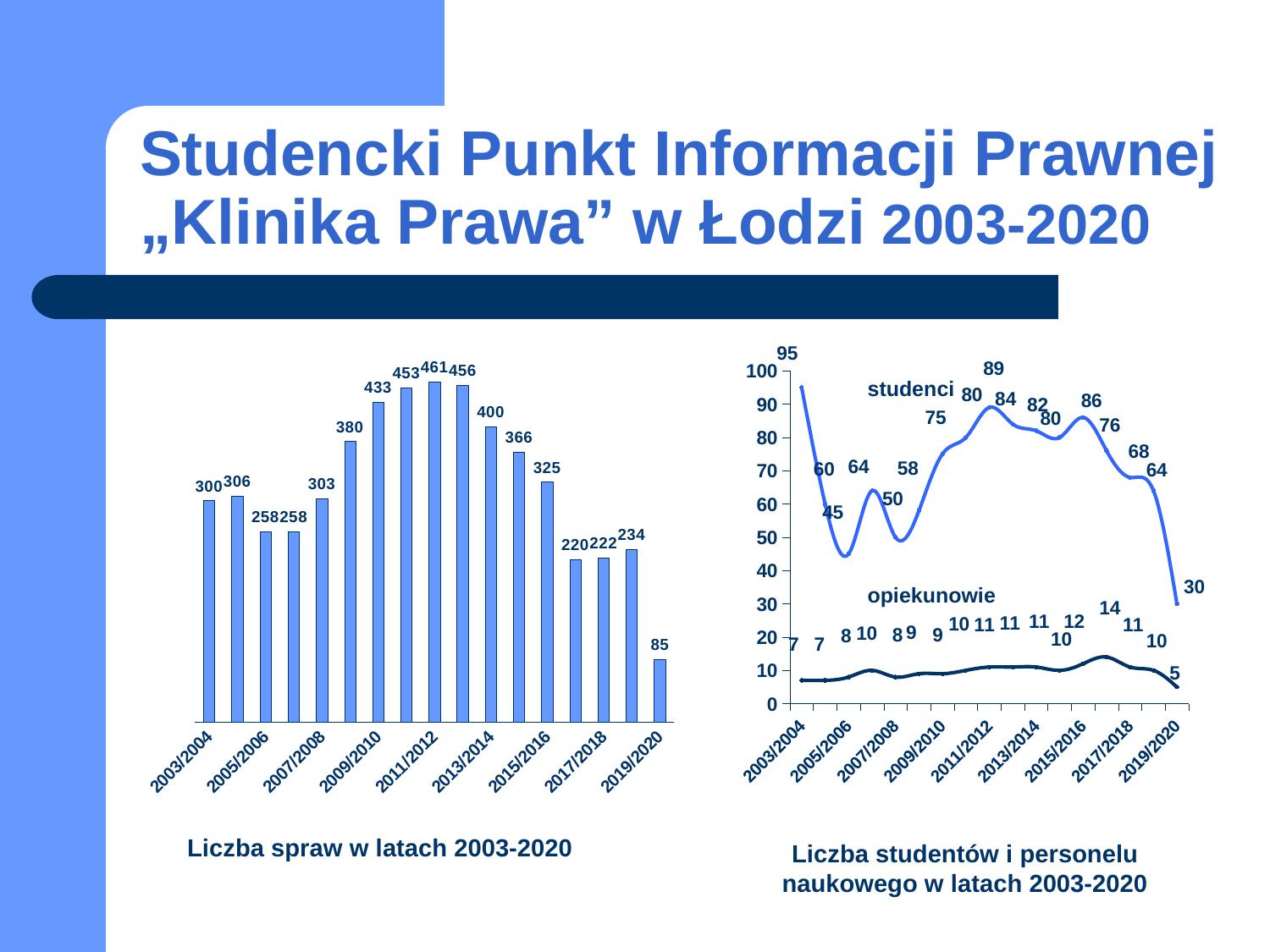
In the right chart 'Liczba studentów i personelu naukowego w latach 2003-2020', what is the value of 'studenci' for 2003/2004? 95 In the left chart 'Liczba spraw w latach 2003-2020', which year has the lowest value? 2019/2020 In the left chart 'Liczba spraw w latach 2003-2020', what is the value for 2011/2012? 461 In the left chart 'Liczba spraw w latach 2003-2020', what is the difference between the values for 2003/2004 and 2019/2020? 215 How many series are plotted in the right chart 'Liczba studentów i personelu naukowego w latach 2003-2020'? 2 What kind of chart is the left chart, 'Liczba spraw w latach 2003-2020'? bar chart In the left chart 'Liczba spraw w latach 2003-2020', which year has the highest value? 2011/2012 In the right chart 'Liczba studentów i personelu naukowego w latach 2003-2020', what is the value of 'opiekunowie' for 2019/2020? 5 In the left chart 'Liczba spraw w latach 2003-2020', do the values rise or fall from 2011/2012 to 2019/2020? fall How many bars are plotted in the left chart 'Liczba spraw w latach 2003-2020'? 17 What kind of chart is the right chart, 'Liczba studentów i personelu naukowego w latach 2003-2020'? line chart In the right chart 'Liczba studentów i personelu naukowego w latach 2003-2020', which year has the highest 'studenci' value? 2003/2004